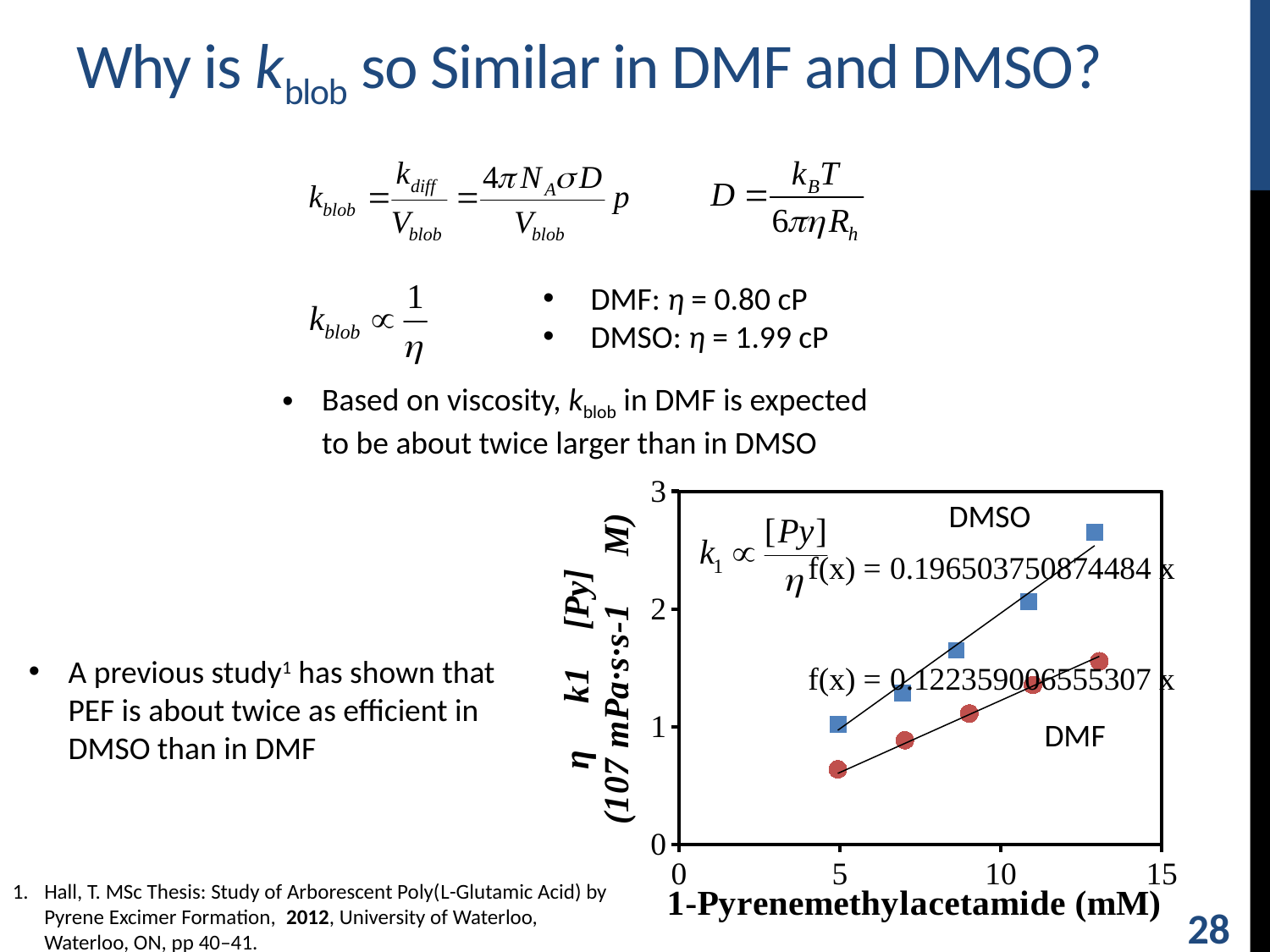
How many data series are plotted in the chart? 2 What is the title of the x axis of the chart? 1-Pyrenemethylacetamide (mM) What is the trendline equation shown for the DMSO series? f(x) = 0.196503750874484 x Which series has the higher values at the same concentration, DMSO or DMF? DMSO Is the value of the highest DMF point greater or less than 2? less Do the DMSO values rise or fall as the 1-Pyrenemethylacetamide concentration increases? rise Is the value of the highest DMSO point greater or less than 2? greater What kind of chart is shown on the slide? scatter chart How many data points are plotted for the DMF series? 5 What is the trendline equation shown for the DMF series? f(x) = 0.122359006555307 x Which series has the steeper trendline slope, DMSO or DMF? DMSO How many data points are plotted for the DMSO series? 5